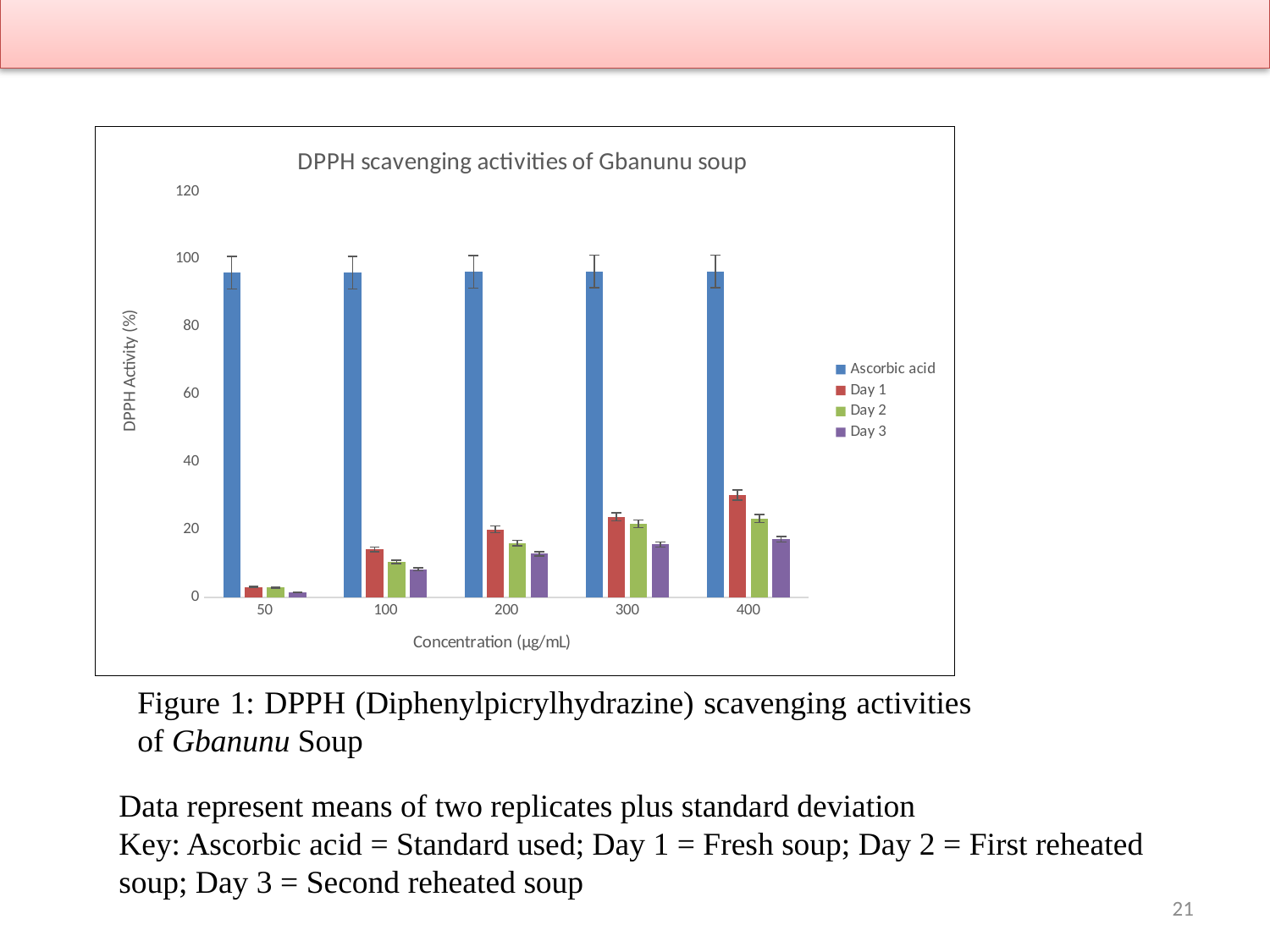
How many concentration categories are shown on the x axis? 5 Is the Day 1 value at 400 µg/mL greater or less than 20? greater Which series has the lowest DPPH activity at a concentration of 400 µg/mL? Day 3 What type of chart is shown on the slide? bar chart What is the title of the chart? DPPH scavenging activities of Gbanunu soup How many series does the legend list? 4 What is the label of the y axis? DPPH Activity (%) Is the Ascorbic acid value at 200 µg/mL greater or less than 80? greater Which is larger at 300 µg/mL, the Day 1 value or the Day 3 value? Day 1 Do the Day 1 values rise or fall as concentration increases from 50 to 400 µg/mL? rise Is the Day 3 value at 100 µg/mL greater or less than 20? less Which series has the highest DPPH activity at a concentration of 400 µg/mL? Ascorbic acid